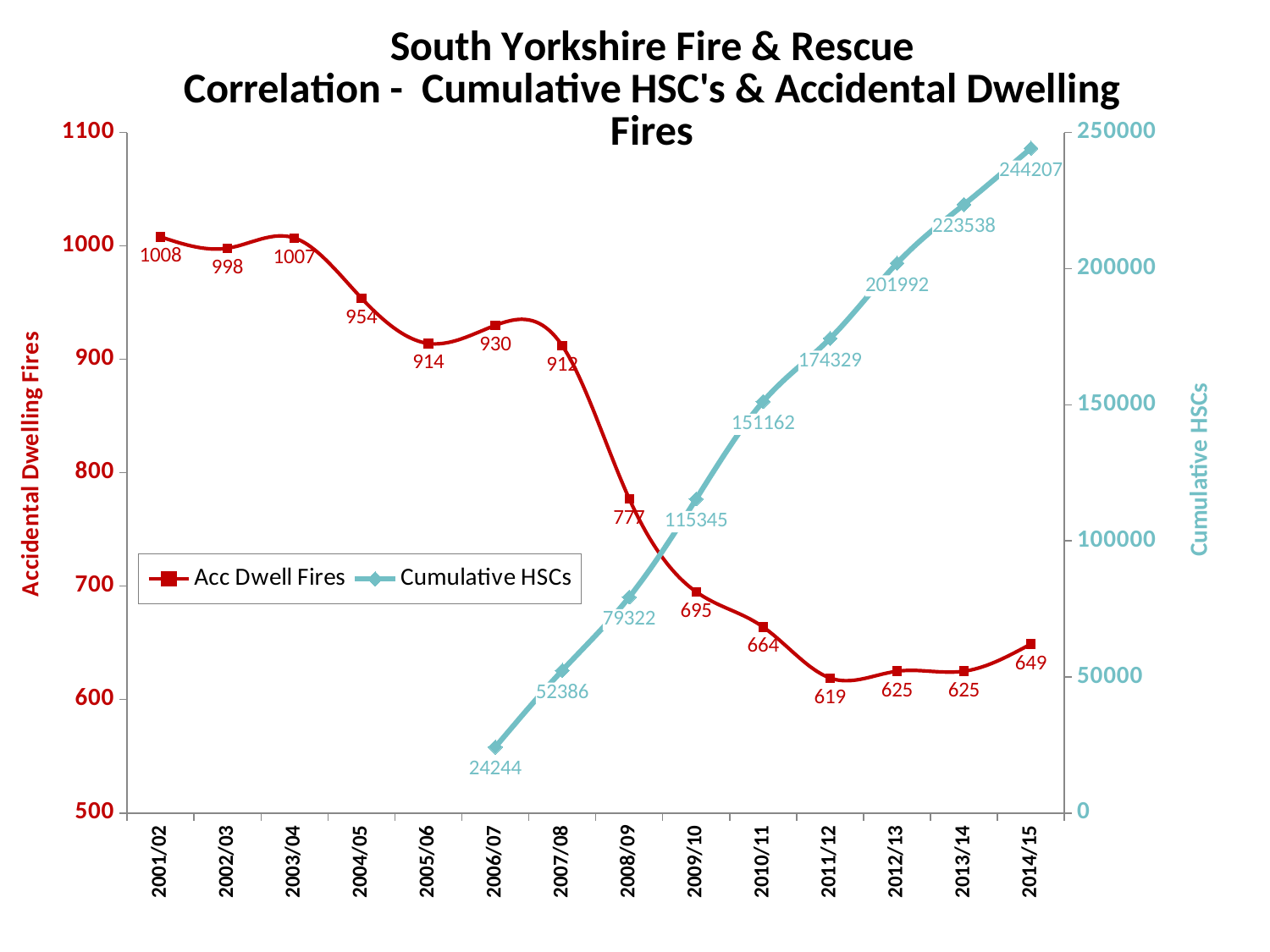
Does the Cumulative HSCs series rise or fall from 2006/07 to 2014/15? rise What is the value of Cumulative HSCs for 2006/07? 24244 In which year is the Acc Dwell Fires value highest? 2001/02 What is the value of Acc Dwell Fires for 2001/02? 1008 Which is larger, the Acc Dwell Fires value for 2004/05 or for 2007/08? 2004/05 How many years are shown on the x axis? 14 What is the difference between the Acc Dwell Fires values for 2001/02 and 2014/15? 359 How many series does the legend list? 2 What kind of chart is this? line chart What is the value of Acc Dwell Fires for 2008/09? 777 In which year is the Acc Dwell Fires value lowest? 2011/12 What is the value of Cumulative HSCs for 2014/15? 244207